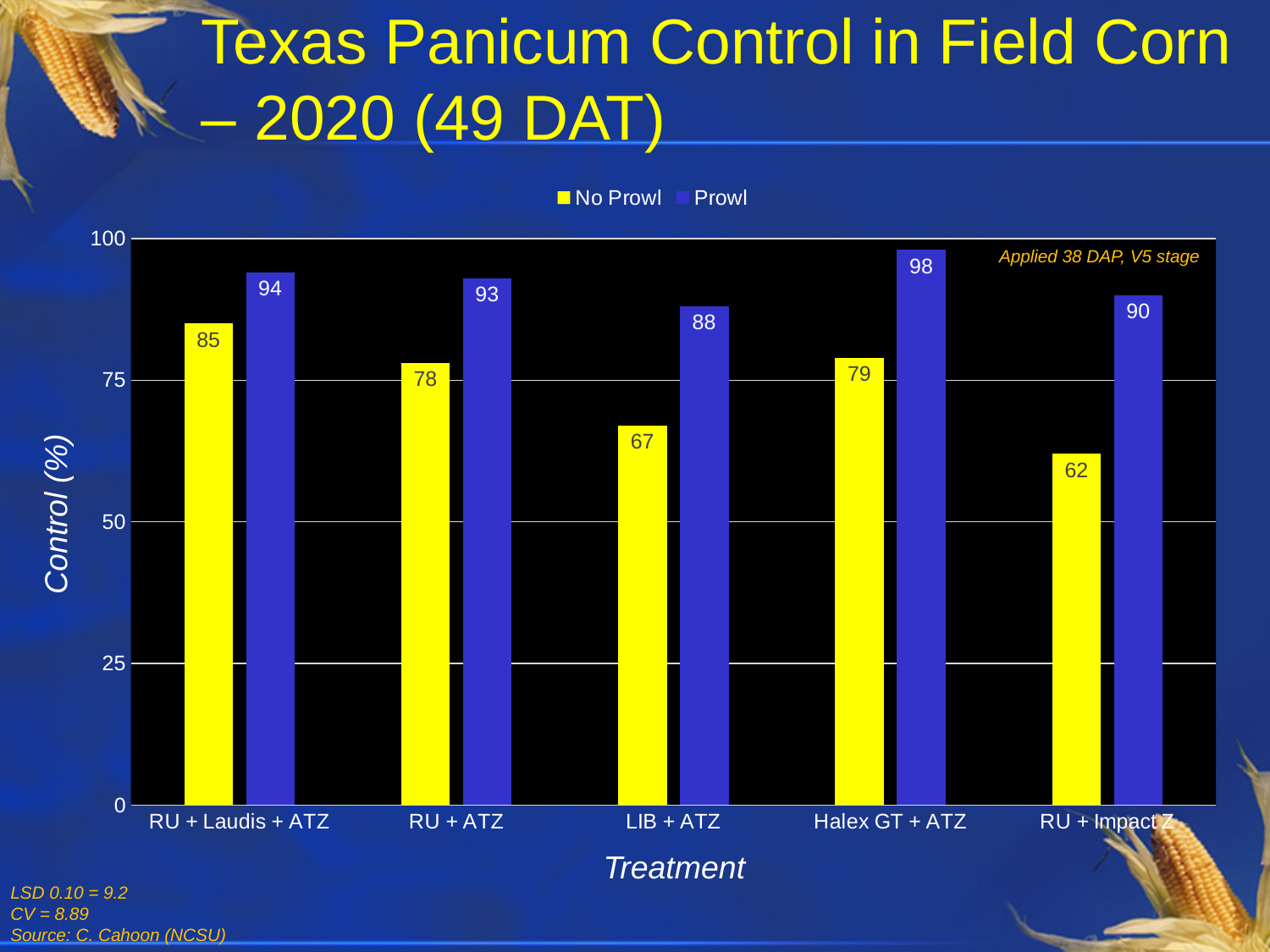
What is the No Prowl control value for RU + Impact Z? 62 Is the No Prowl value for LIB + ATZ greater or less than 75? less What is the No Prowl control value for RU + Laudis + ATZ? 85 What is the label of the y axis? Control (%) Which treatment has the lowest No Prowl control value? RU + Impact Z What is the Prowl control value for Halex GT + ATZ? 98 Which treatment has the highest Prowl control value? Halex GT + ATZ What kind of chart is shown on the slide? bar chart How many treatments are shown on the x axis? 5 What is the difference between the Prowl and No Prowl values for LIB + ATZ? 21 How many series does the legend list? 2 Which is larger for RU + ATZ: the No Prowl value or the Prowl value? Prowl